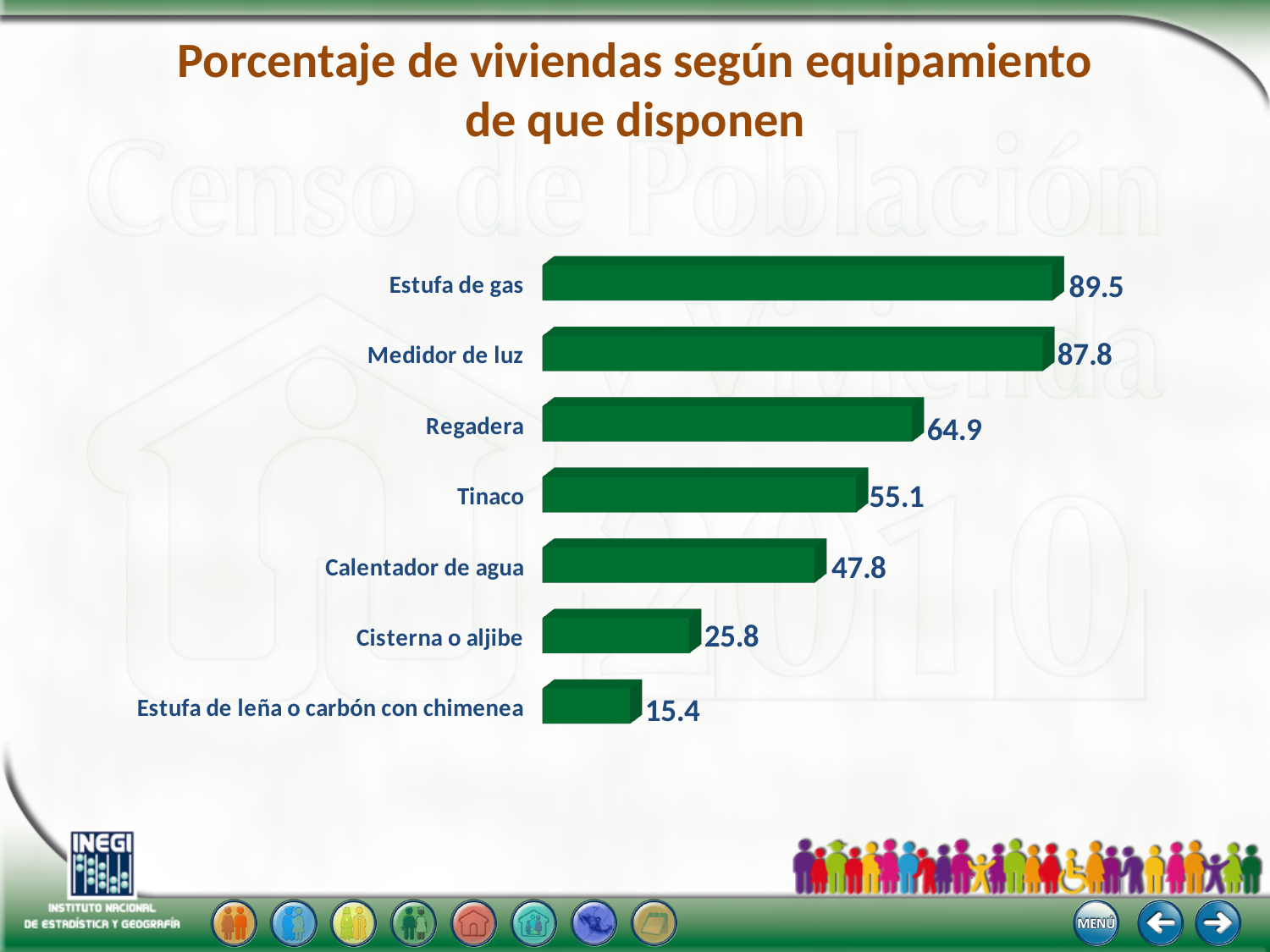
Which category has the lowest value? Estufa de leña o carbón con chimenea What kind of chart is shown on the slide? Bar chart What colour are the bars in the chart? Green Which is larger, the value for Tinaco or the value for Calentador de agua? Tinaco What is the difference between the values for Regadera and Calentador de agua? 17.1 What is the difference between the values for Estufa de gas and Medidor de luz? 1.7 What is the title of the slide? Porcentaje de viviendas según equipamiento de que disponen Which category has the highest value? Estufa de gas What is the value for Cisterna o aljibe? 25.8 What is the value for Tinaco? 55.1 How many categories are shown in the chart? 7 What is the value for Estufa de gas? 89.5